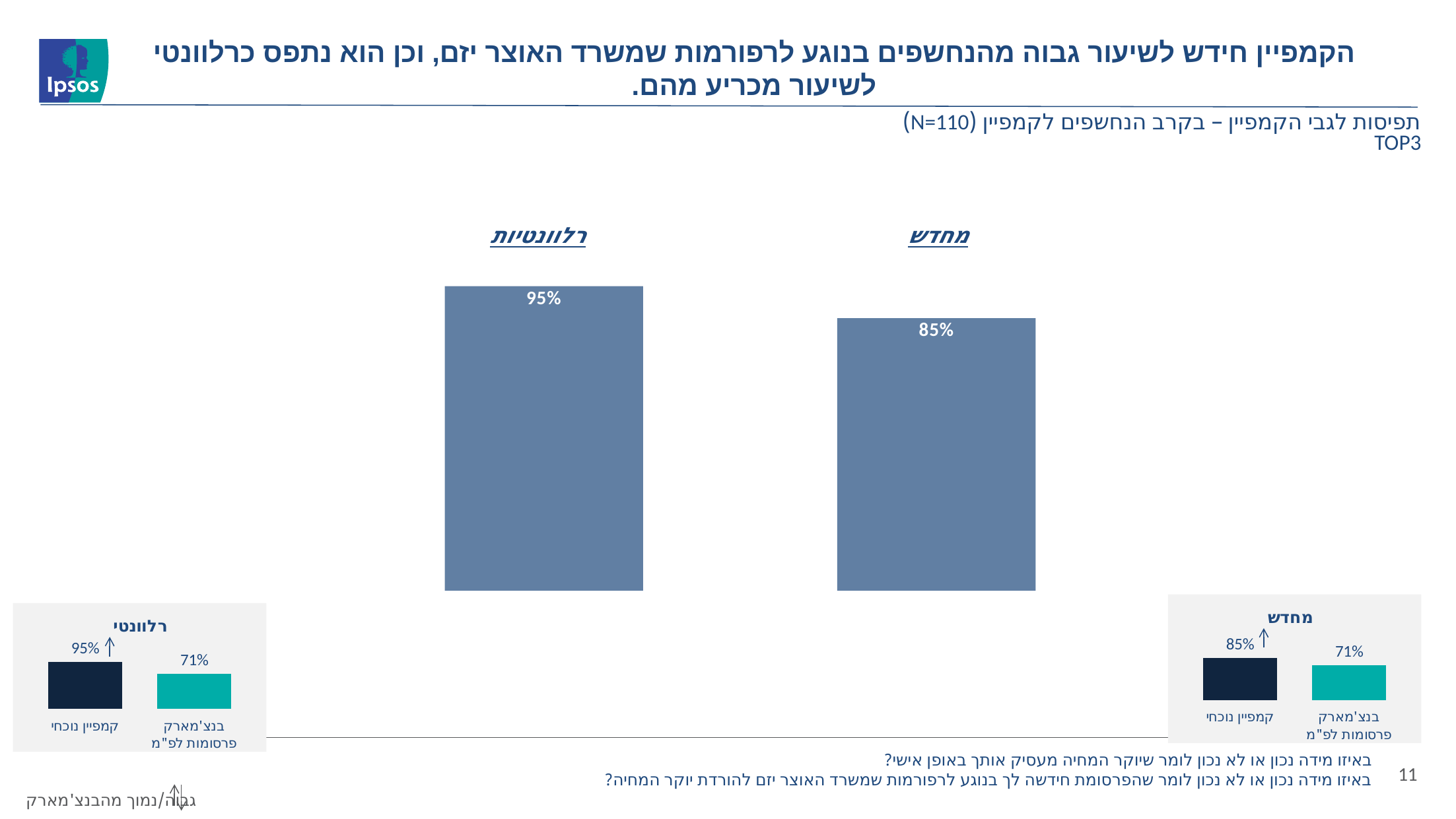
How many bars does the main chart show? 2 In the main chart, what is the value for מחדש? 85% In the small רלוונטי chart at the bottom left, what is the value for בנצ'מארק פרסומות לפ"מ? 71% In the main chart, what is the difference between the values for רלוונטיות and מחדש? 10% In the main chart, what is the value for רלוונטיות? 95% In the small מחדש chart at the bottom right, what is the value for קמפיין נוכחי? 85% What kind of chart is the main chart on the slide? bar chart In the main chart, which category has the higher value, רלוונטיות or מחדש? רלוונטיות In the small רלוונטי chart at the bottom left, which is larger, קמפיין נוכחי or בנצ'מארק פרסומות לפ"מ? קמפיין נוכחי What sample size (N) is stated in the subtitle of the slide? N=110 In the small רלוונטי chart at the bottom left, what is the value for קמפיין נוכחי? 95% In the small מחדש chart at the bottom right, what is the difference between קמפיין נוכחי and בנצ'מארק פרסומות לפ"מ? 14%